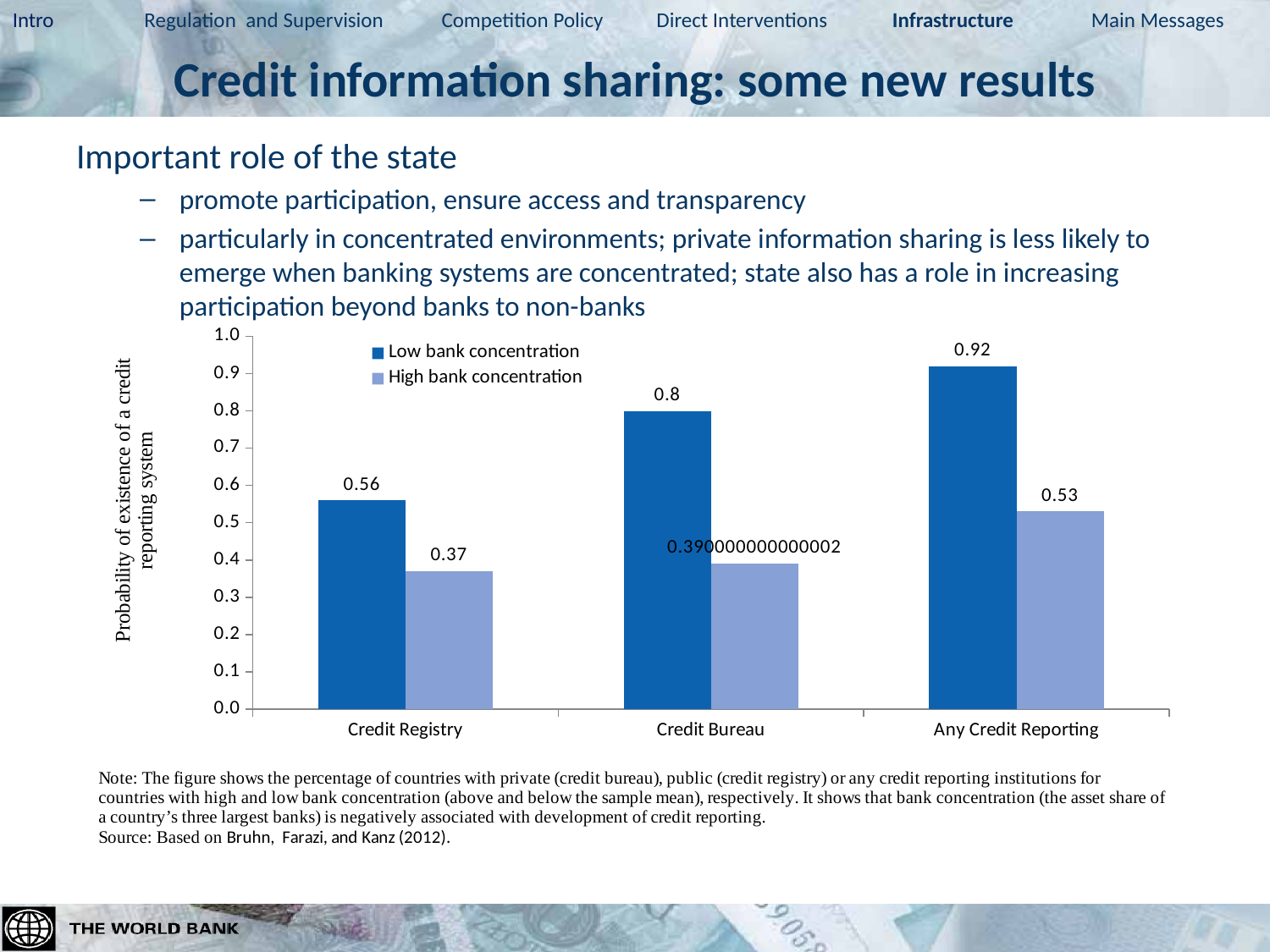
What is the difference between the Low bank concentration and High bank concentration values for Any Credit Reporting? 0.39 How many categories are shown on the x axis of the chart? 3 What is the value for High bank concentration in the Credit Registry category? 0.37 What is the value for High bank concentration in the Any Credit Reporting category? 0.53 What is the value for Low bank concentration in the Credit Registry category? 0.56 How many series does the chart legend list? 2 Which is larger in the Credit Registry category: Low bank concentration or High bank concentration? Low bank concentration What kind of chart is shown on the slide? Bar chart Which category has the highest value for Low bank concentration? Any Credit Reporting What is the value for Low bank concentration in the Credit Bureau category? 0.8 Is the value for High bank concentration in the Credit Bureau category greater or less than 0.5? less Which category has the lowest value for High bank concentration? Credit Registry